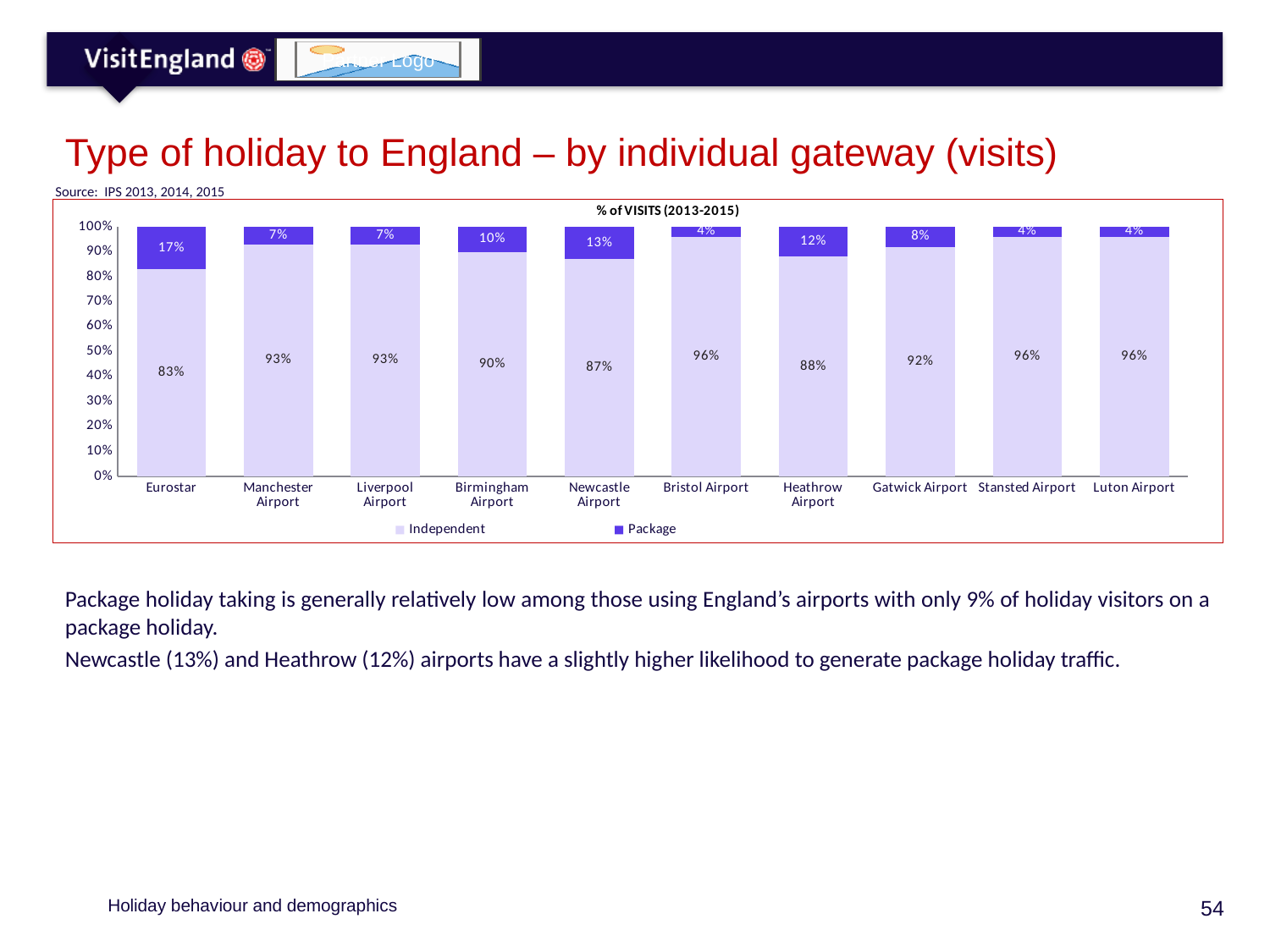
How many series does the legend list? 2 What is the difference between the Package shares of Eurostar and Gatwick Airport? 9 percentage points What is the Independent share for Birmingham Airport? 90% Which gateway has the lowest Independent share? Eurostar What is the Package share for Heathrow Airport? 12% What is the title shown above the chart? % of VISITS (2013-2015) Which has a larger Package share, Newcastle Airport or Manchester Airport? Newcastle Airport Which gateway has the highest Package share? Eurostar What is the Package share for Newcastle Airport? 13% What is the Independent share for Eurostar? 83% What kind of chart is shown? Stacked bar chart How many gateways are shown on the x axis? 10